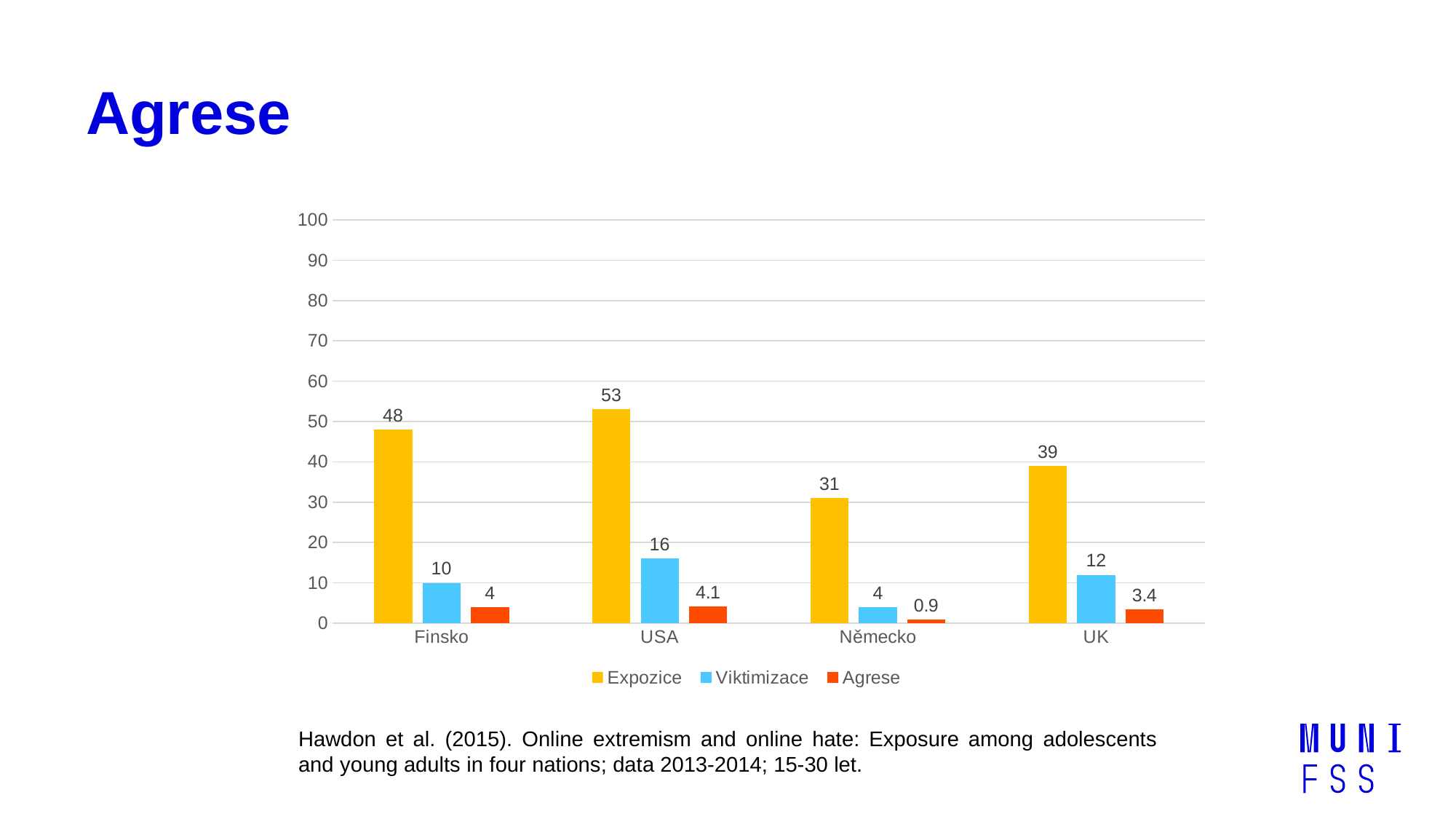
What is the Viktimizace value for UK? 12 What is the Expozice value for Finsko? 48 What is the difference between the Expozice values for USA and Německo? 22 How many series does the legend list? 3 Which country has the lowest Agrese value? Německo Is the Expozice value for UK greater or less than 30? greater Which series is shown in orange-red in the legend? Agrese Which is larger, the Viktimizace value for USA or for UK? USA Which country has the highest Expozice value? USA What is the Agrese value for Německo? 0.9 How many countries are shown on the x axis? 4 What kind of chart is shown on the slide? bar chart